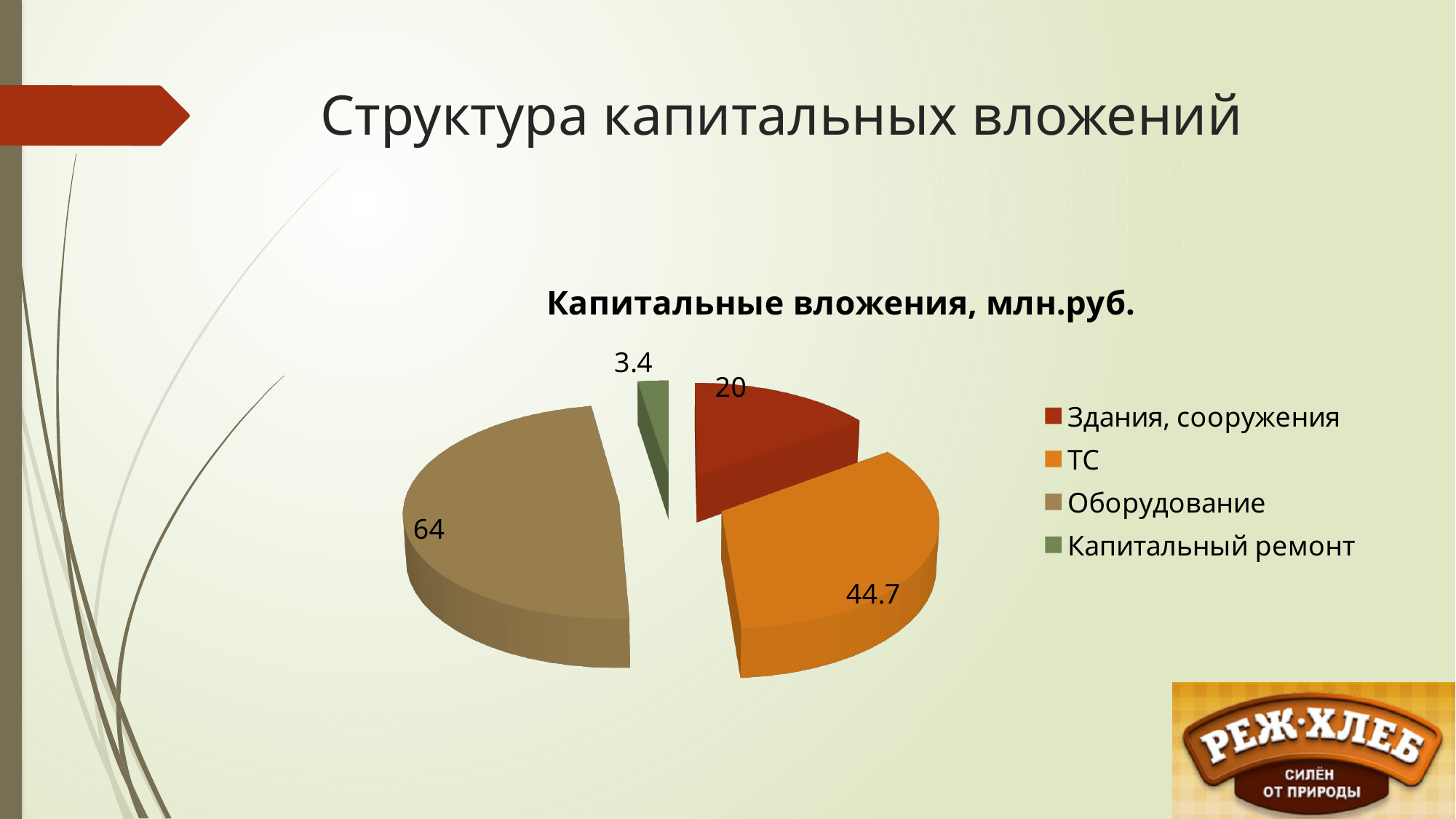
What is the value for Оборудование? 64 What is the difference between the values for Оборудование and ТС? 19.3 What type of chart is shown on the slide? Pie chart Which is larger, the value for ТС or the value for Здания, сооружения? ТС What is the value for Капитальный ремонт? 3.4 How many categories does the pie chart have? 4 What is the total of all slices in the pie chart? 132.1 What is the title of the chart? Капитальные вложения, млн.руб. What is the value for Здания, сооружения? 20 Which category has the smallest slice? Капитальный ремонт Which category has the largest slice? Оборудование What is the value for ТС? 44.7